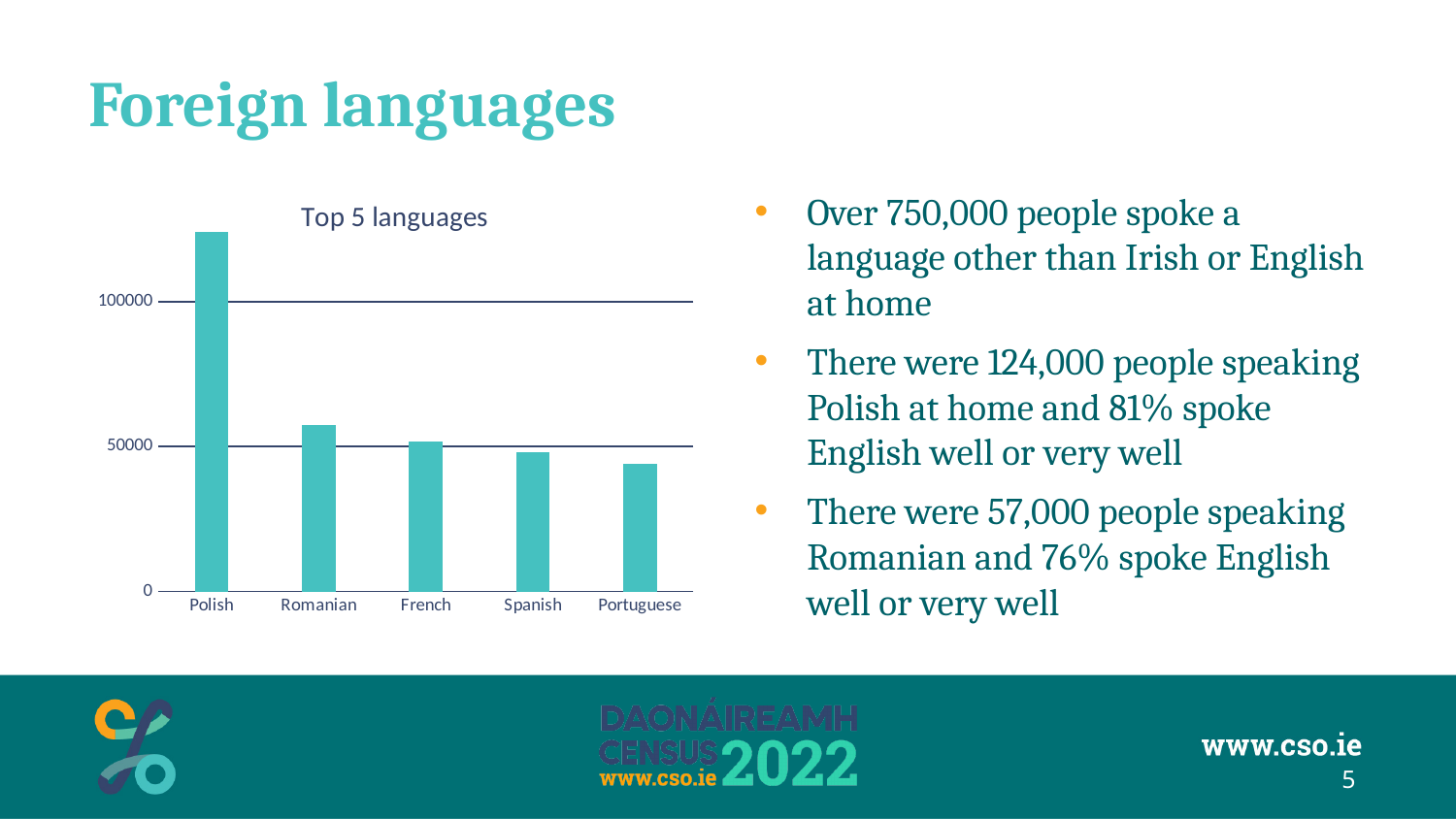
Is the value for Romanian greater or less than 50000? greater How many languages are shown in the chart? 5 Do the values rise or fall from left to right across the languages? fall Which is larger, the value for Romanian or the value for French? Romanian What type of chart is shown on the slide? bar chart Which language has the highest value in the chart? Polish Is the value for Spanish greater or less than 50000? less Is the value for Polish greater or less than 100000? greater What is the title of the chart? Top 5 languages Which is larger, the value for Polish or the value for Romanian? Polish Which language has the lowest value in the chart? Portuguese